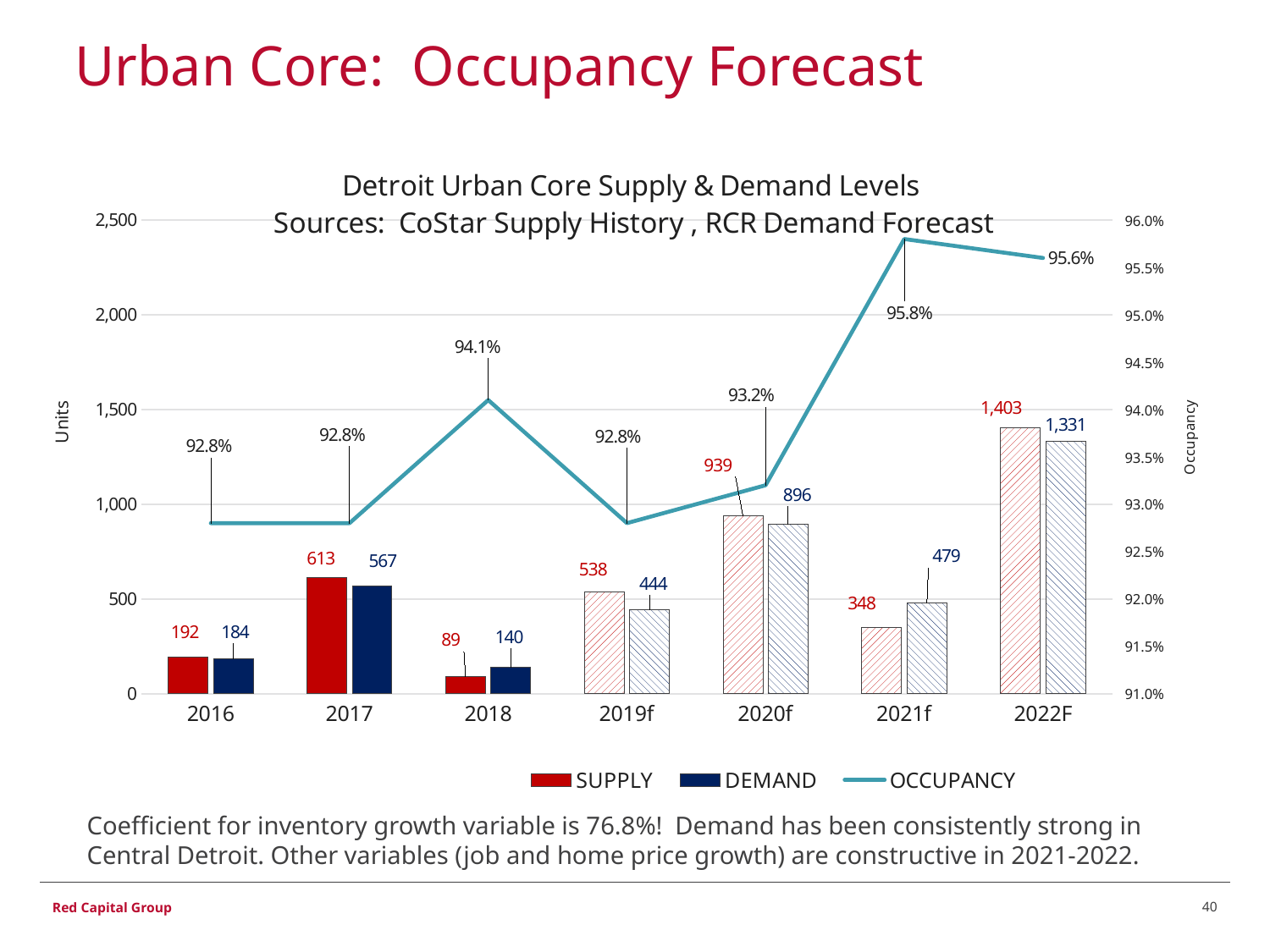
What is the DEMAND value for 2018? 140 Which year has the lowest SUPPLY value? 2018 Which year has the highest OCCUPANCY value? 2021f How many years are shown on the x axis? 7 In 2021f, which is larger, SUPPLY or DEMAND? DEMAND What is the OCCUPANCY value for 2018? 94.1% What is the DEMAND value for 2022F? 1,331 How many series does the legend list? 3 What is the difference between SUPPLY and DEMAND in 2017? 46 What is the SUPPLY value for 2020f? 939 Does OCCUPANCY rise or fall from 2020f to 2021f? rise Which year has the highest SUPPLY value? 2022F